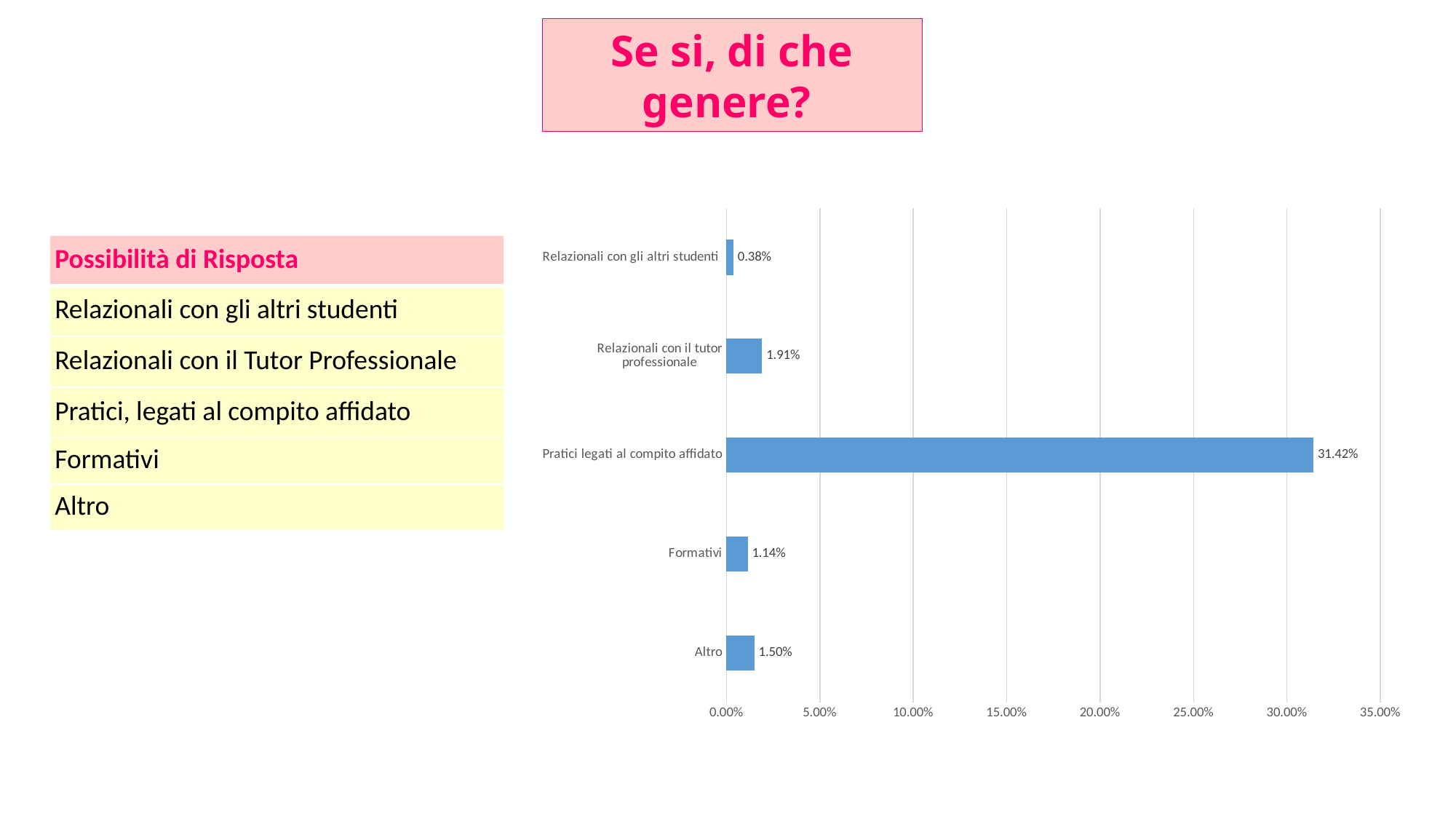
What is the value for Pratici legati al compito affidato? 31.42% How many categories are shown in the chart? 5 Which category has the lowest value? Relazionali con gli altri studenti Which category has the highest value? Pratici legati al compito affidato What is the value for Relazionali con gli altri studenti? 0.38% What is the value for Formativi? 1.14% What is the value for Relazionali con il tutor professionale? 1.91% What is the value for Altro? 1.50% What kind of chart is shown on the slide? bar chart What is the difference between the values for Relazionali con il tutor professionale and Formativi? 0.77% Which is larger, the value for Altro or the value for Formativi? Altro Is the value for Pratici legati al compito affidato greater or less than 30.00%? greater